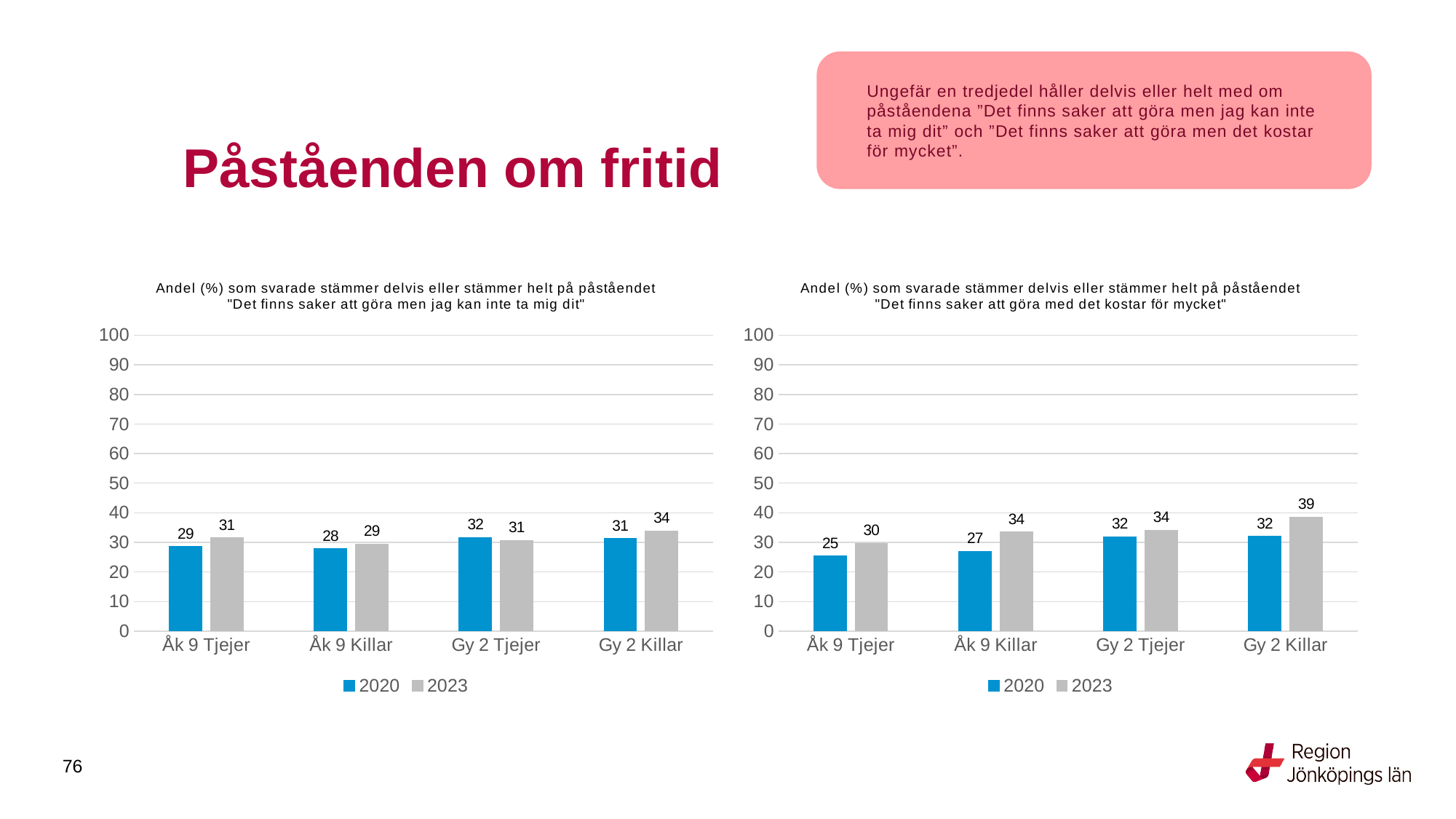
In the left chart ("Det finns saker att göra men jag kan inte ta mig dit"), what is the value for Gy 2 Killar in 2023? 34 In the right chart ("Det finns saker att göra med det kostar för mycket"), what is the difference between the 2023 and 2020 values for Åk 9 Killar? 7 How many categories are shown on the x axis of the left chart? 4 In the left chart ("Det finns saker att göra men jag kan inte ta mig dit"), which is larger for Gy 2 Tjejer: the 2020 value or the 2023 value? 2020 What kind of chart is the left chart? bar chart In the right chart ("Det finns saker att göra med det kostar för mycket"), which category has the highest 2023 value? Gy 2 Killar In the right chart ("Det finns saker att göra med det kostar för mycket"), is the 2023 value for Gy 2 Killar greater or less than 40? less In the left chart ("Det finns saker att göra men jag kan inte ta mig dit"), what is the value for Åk 9 Tjejer in 2020? 29 In the right chart ("Det finns saker att göra med det kostar för mycket"), what is the value for Åk 9 Tjejer in 2020? 25 In the left chart ("Det finns saker att göra men jag kan inte ta mig dit"), which category has the lowest 2020 value? Åk 9 Killar How many series does the legend of the right chart list? 2 In the right chart ("Det finns saker att göra med det kostar för mycket"), which category has the lowest 2020 value? Åk 9 Tjejer